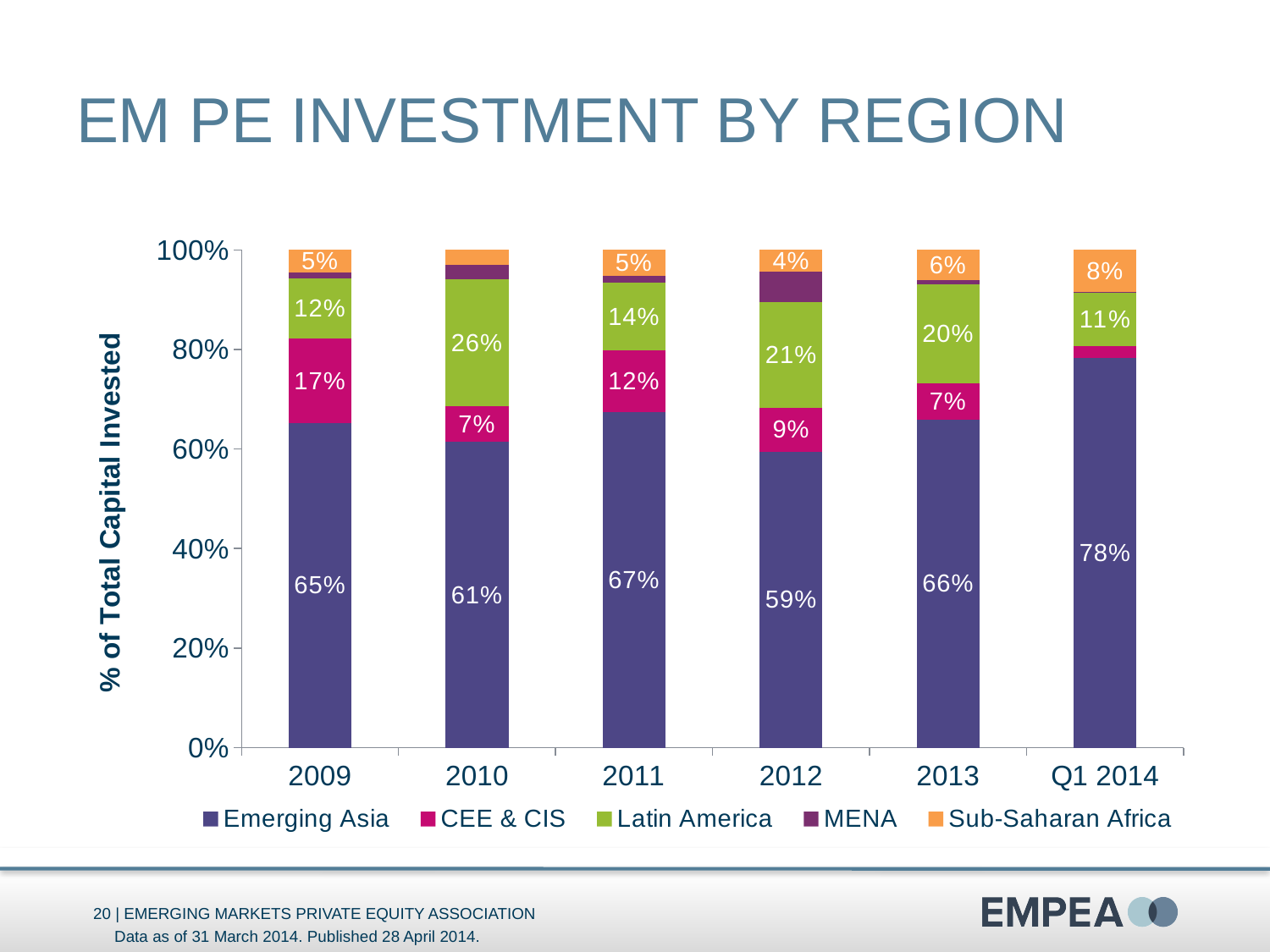
How many series does the legend list? 5 Which was larger in 2012: the Latin America share or the CEE & CIS share? Latin America How many time periods are shown on the x axis? 6 What share of total capital invested went to Emerging Asia in Q1 2014? 78% In which period was Emerging Asia's share of total capital invested the highest? Q1 2014 What was the CEE & CIS share of total capital invested in 2009? 17% By how many percentage points did Emerging Asia's share change from 2013 to Q1 2014? 12 percentage points In which period was Emerging Asia's share of total capital invested the lowest? 2012 What was Latin America's share of total capital invested in 2010? 26% What is the label on the y axis? % of Total Capital Invested What type of chart is shown on the slide? stacked bar chart Is the Emerging Asia share in 2011 greater or less than 60%? greater